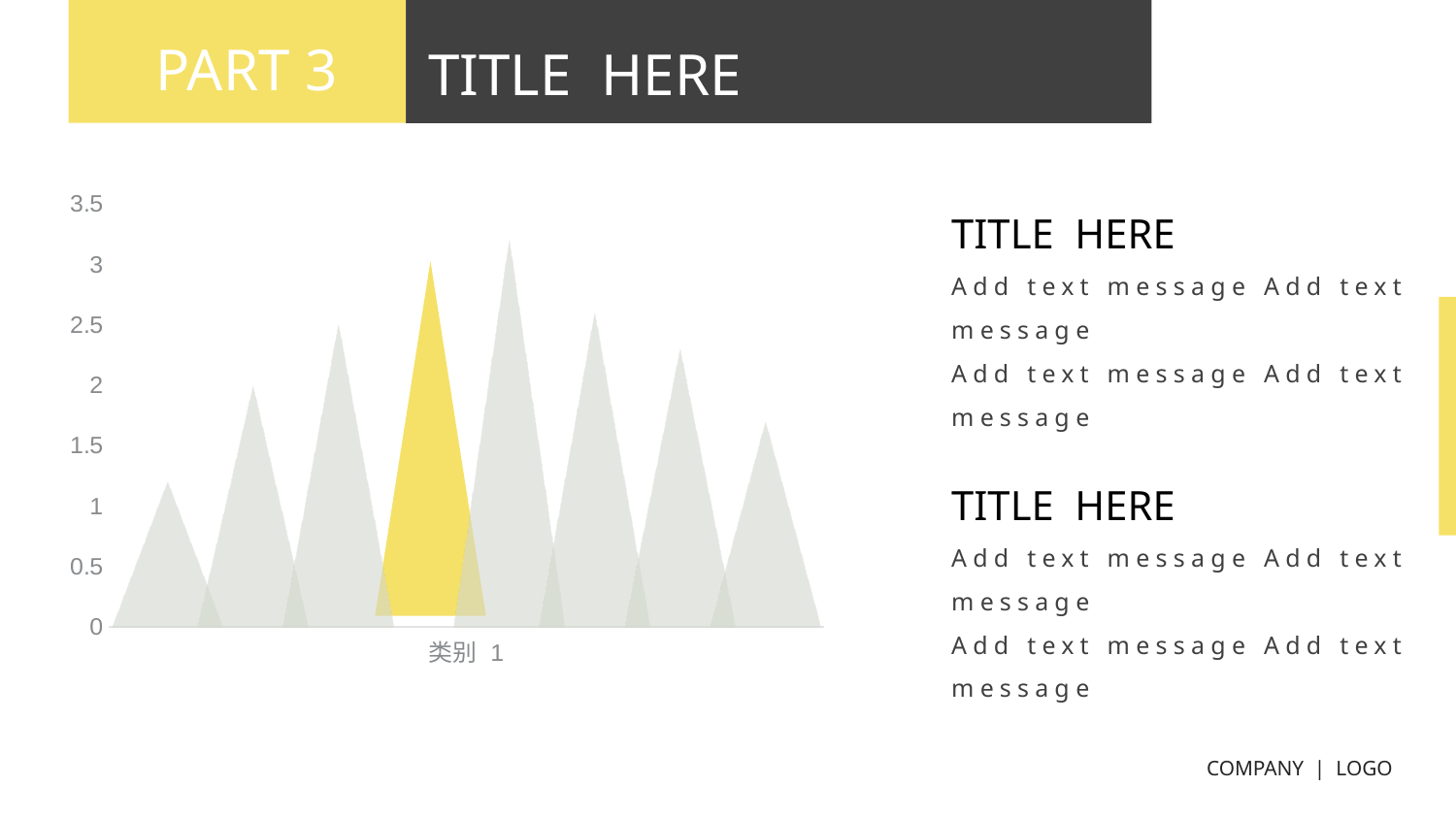
Which bar is the highest in the chart? the fifth bar from the left (the gray bar right of the yellow one) Which bar is the lowest in the chart, the leftmost bar or the yellow bar? the leftmost bar Is the value of the yellow bar greater or less than 2.5? greater Is the value of the rightmost bar greater or less than 2? less Is the value of the tallest bar greater or less than 3? greater Which is larger, the yellow bar or the leftmost bar? the yellow bar How many triangular bars are plotted in the chart? 8 How many categories are labelled on the x axis of the chart? 1 What kind of chart is shown on the slide? bar chart What is the highest value shown on the y axis of the chart? 3.5 What is the category label shown on the x axis of the chart? 类别 1